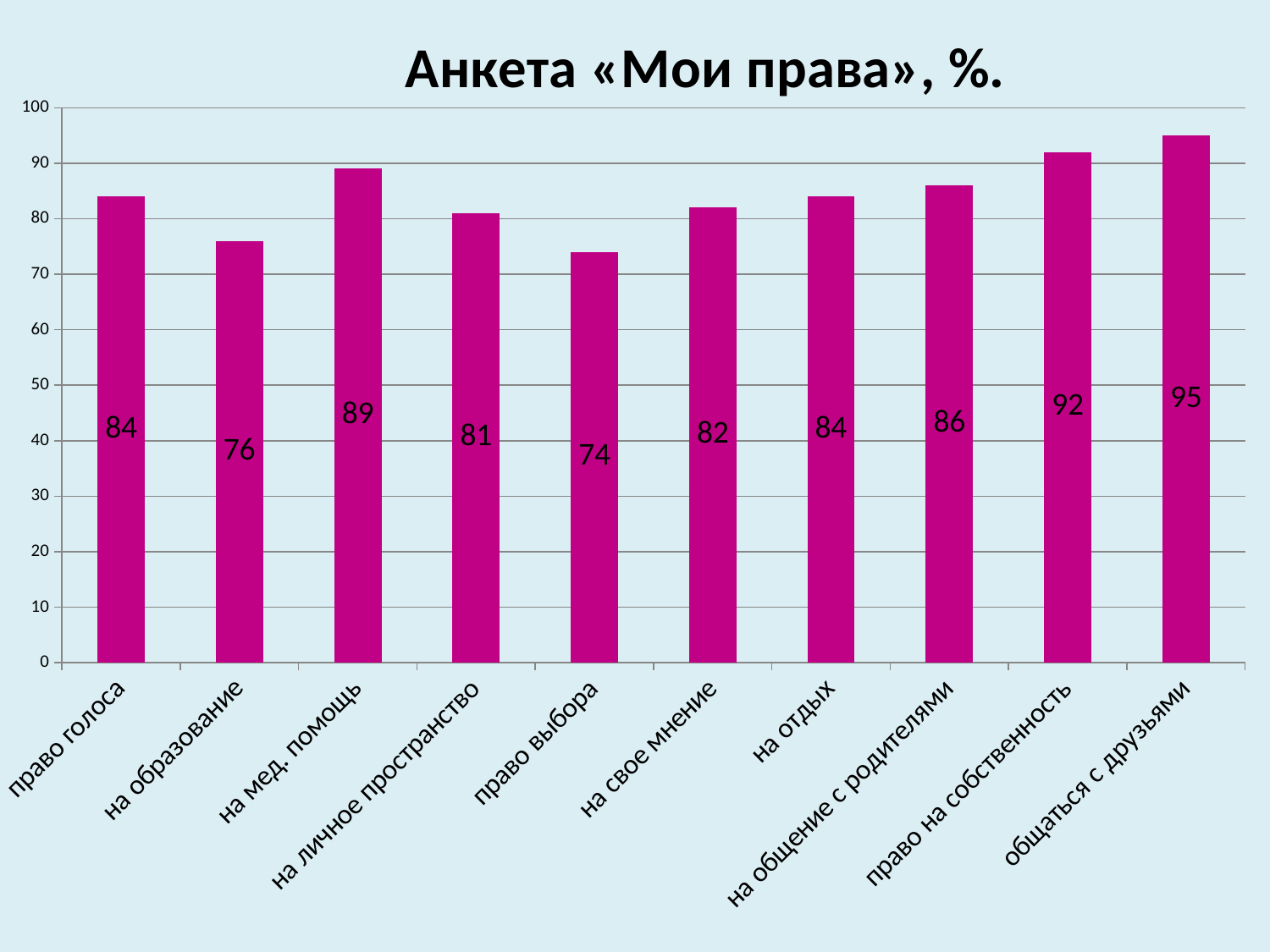
What is the value for «на личное пространство»? 81 What colour are the bars in the chart? magenta Which is larger: the value for «на свое мнение» or the value for «на общение с родителями»? на общение с родителями What is the value for «право голоса»? 84 How many categories are shown on the chart? 10 What is the value for «право на собственность»? 92 What is the title of the chart? Анкета «Мои права», %. Which category has the lowest value? право выбора What kind of chart is shown on the slide? bar chart Which category has the highest value? общаться с друзьями What is the difference between the values for «на мед. помощь» and «на образование»? 13 Is the value for «право выбора» greater or less than 80? less